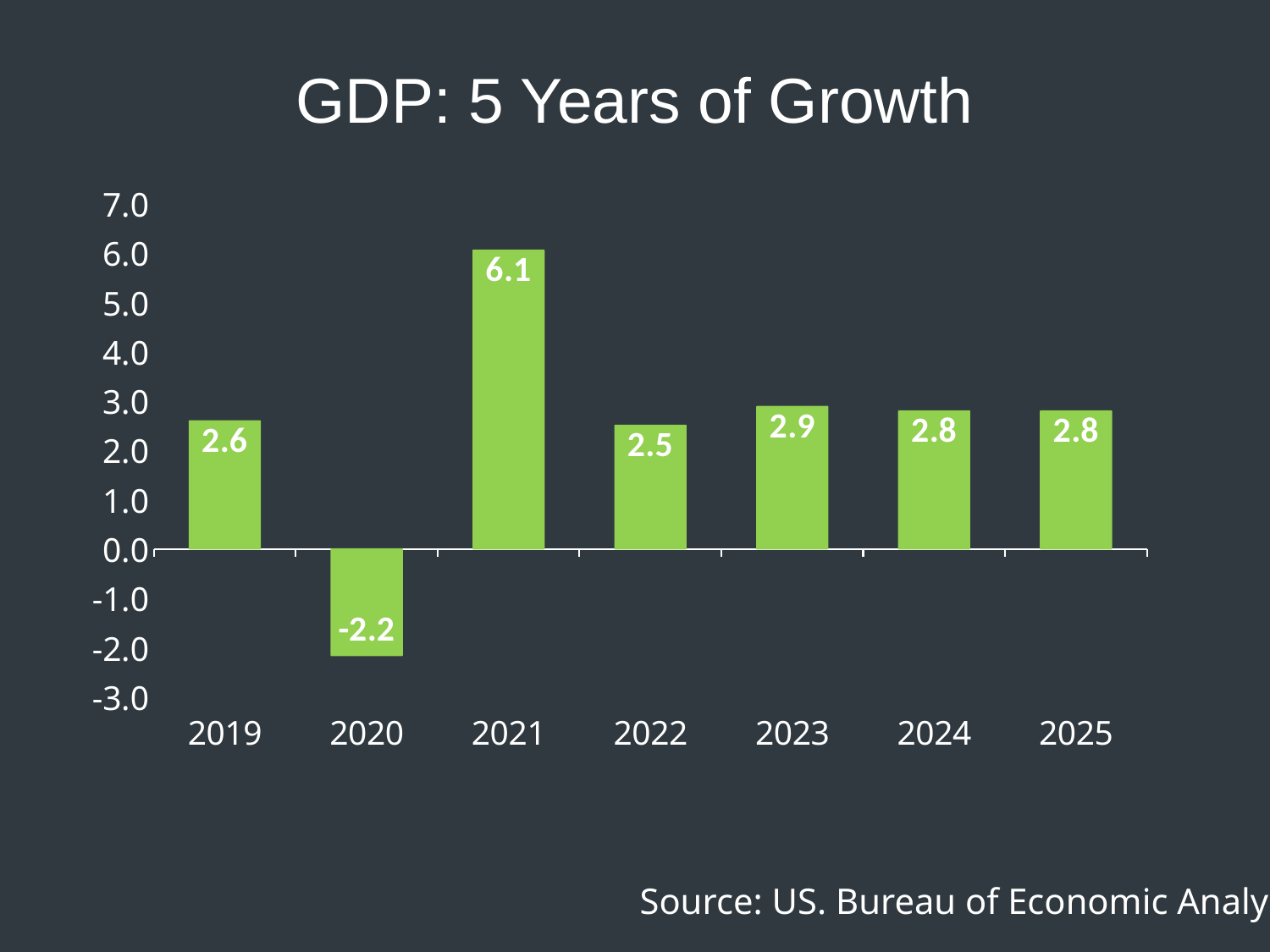
Is the value for 2021 greater or less than 5.0? greater Which year has the lowest value? 2020 What is the GDP growth value for 2020? -2.2 How many years are shown on the chart? 7 Which is larger, the value for 2019 or the value for 2022? 2019 Which year has the highest value? 2021 What is the value shown for 2023? 2.9 What is the title of the chart? GDP: 5 Years of Growth What is the GDP growth value for 2021? 6.1 What is the difference between the values for 2023 and 2022? 0.4 What is the difference between the values for 2021 and 2019? 3.5 What kind of chart is shown on the slide? bar chart